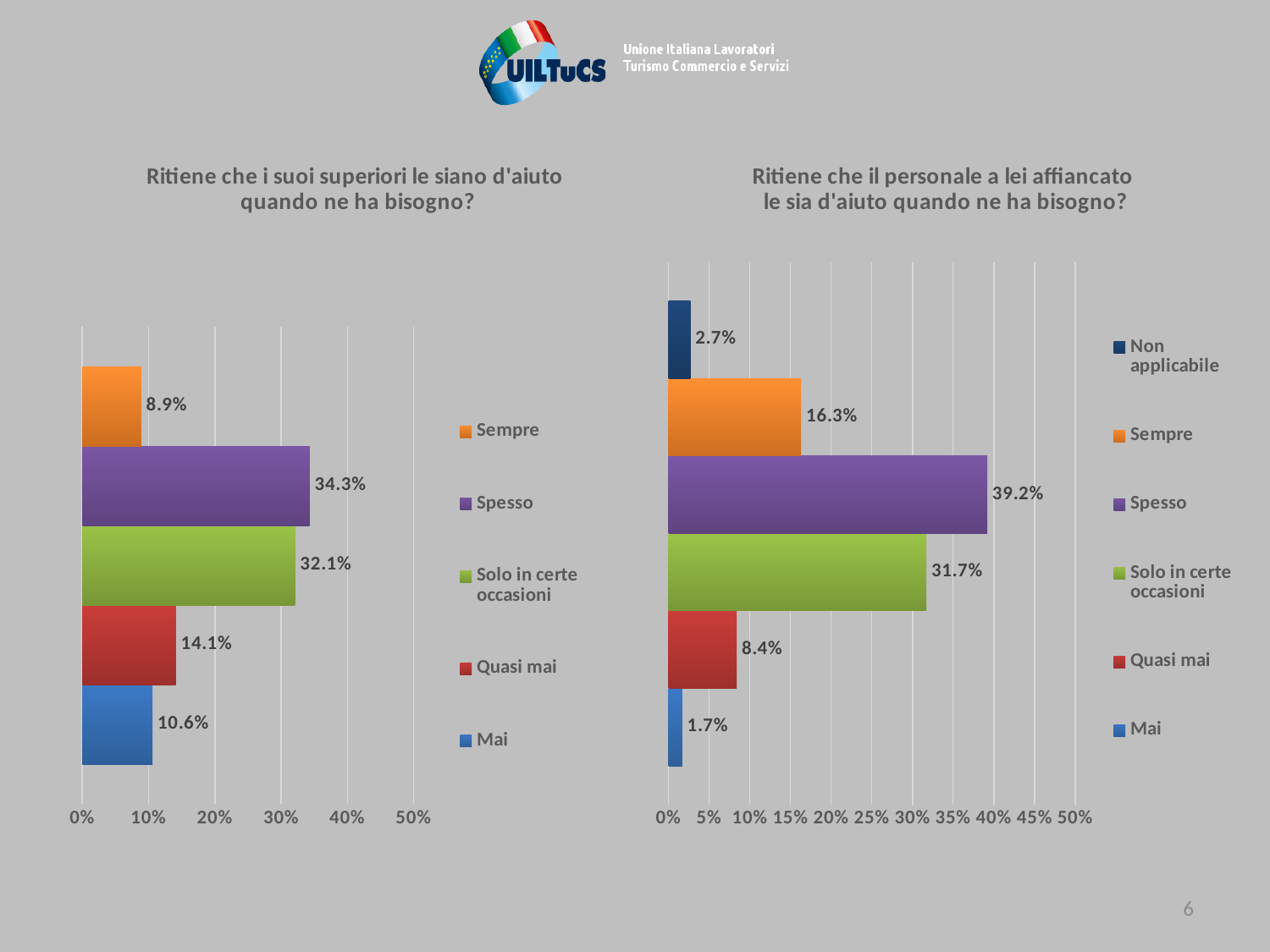
In the left chart ('Ritiene che i suoi superiori le siano d'aiuto quando ne ha bisogno?'), what is the difference between 'Quasi mai' and 'Mai'? 3.5% Which is larger: 'Spesso' in the left chart or 'Spesso' in the right chart? Spesso in the right chart In the left chart ('Ritiene che i suoi superiori le siano d'aiuto quando ne ha bisogno?'), what is the value for 'Mai'? 10.6% In the right chart ('Ritiene che il personale a lei affiancato le sia d'aiuto quando ne ha bisogno?'), what is the value for 'Sempre'? 16.3% What kind of chart is the left chart ('Ritiene che i suoi superiori le siano d'aiuto quando ne ha bisogno?')? Bar chart In the right chart ('Ritiene che il personale a lei affiancato le sia d'aiuto quando ne ha bisogno?'), which category has the lowest value? Mai In the right chart ('Ritiene che il personale a lei affiancato le sia d'aiuto quando ne ha bisogno?'), which category has the highest value? Spesso In the right chart ('Ritiene che il personale a lei affiancato le sia d'aiuto quando ne ha bisogno?'), what is the difference between 'Spesso' and 'Solo in certe occasioni'? 7.5% In the left chart ('Ritiene che i suoi superiori le siano d'aiuto quando ne ha bisogno?'), what is the value for 'Spesso'? 34.3% In the left chart ('Ritiene che i suoi superiori le siano d'aiuto quando ne ha bisogno?'), how many categories does the legend list? 5 In the right chart ('Ritiene che il personale a lei affiancato le sia d'aiuto quando ne ha bisogno?'), how many bars are plotted? 6 In the left chart ('Ritiene che i suoi superiori le siano d'aiuto quando ne ha bisogno?'), which category has the lowest value? Sempre